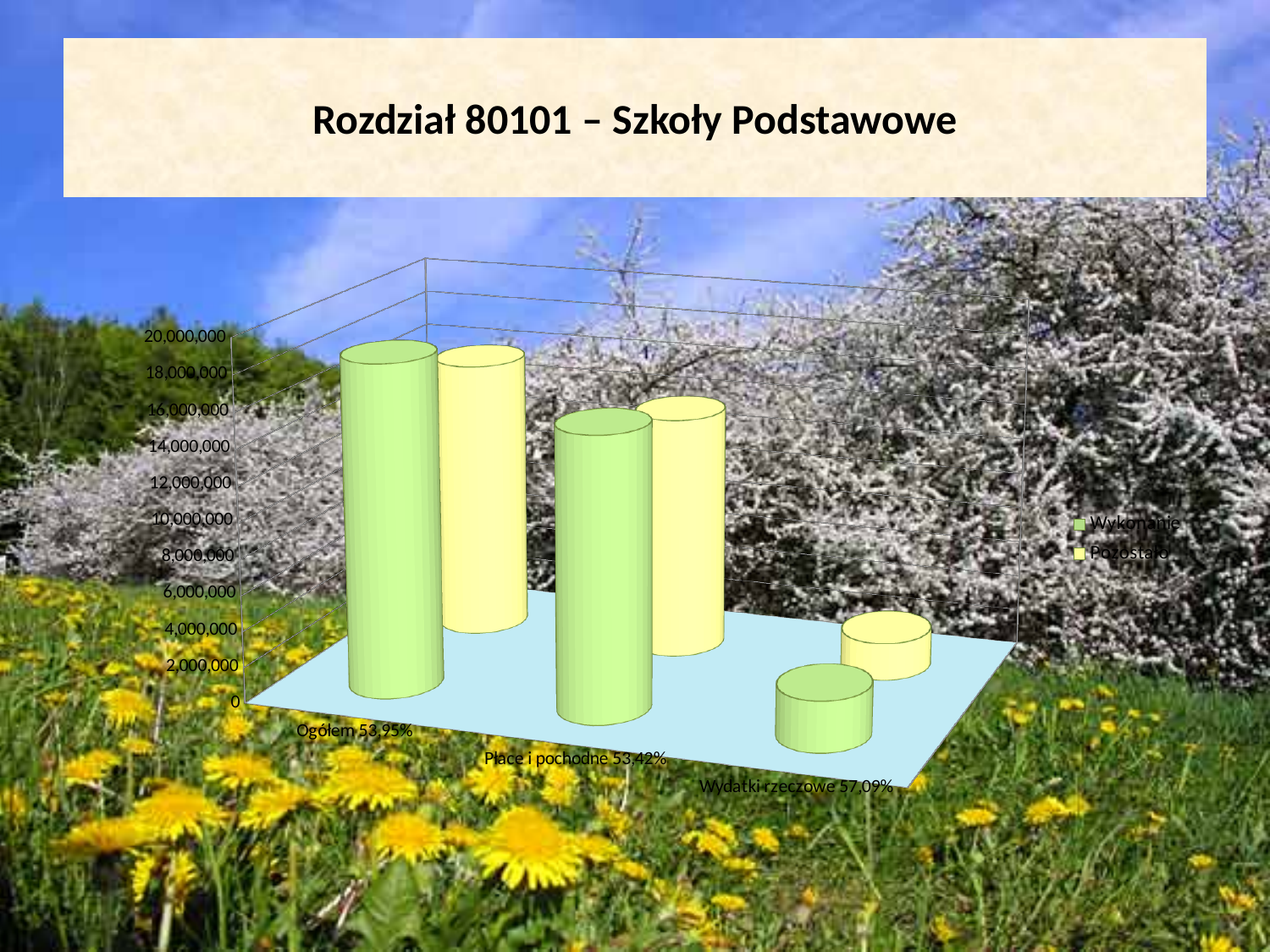
Which category has the lowest Pozostało value? Wydatki rzeczowe 57,09% Which category has the highest Wykonanie value? Ogółem 53,95% How many categories are shown on the x axis? 3 How many series does the legend list? 2 Is the Wykonanie value for Wydatki rzeczowe greater or less than 6,000,000? less Which legend entry is shown in green? Wykonanie Is the Wykonanie value for Ogółem greater or less than 10,000,000? greater What kind of chart is shown on the slide? bar chart Do the Wykonanie values rise or fall from left to right along the x axis? fall What is the title of the slide? Rozdział 80101 – Szkoły Podstawowe Is the Pozostało value for Płace i pochodne greater or less than 8,000,000? greater Which is larger: the Wykonanie value for Ogółem or the Wykonanie value for Wydatki rzeczowe? Ogółem